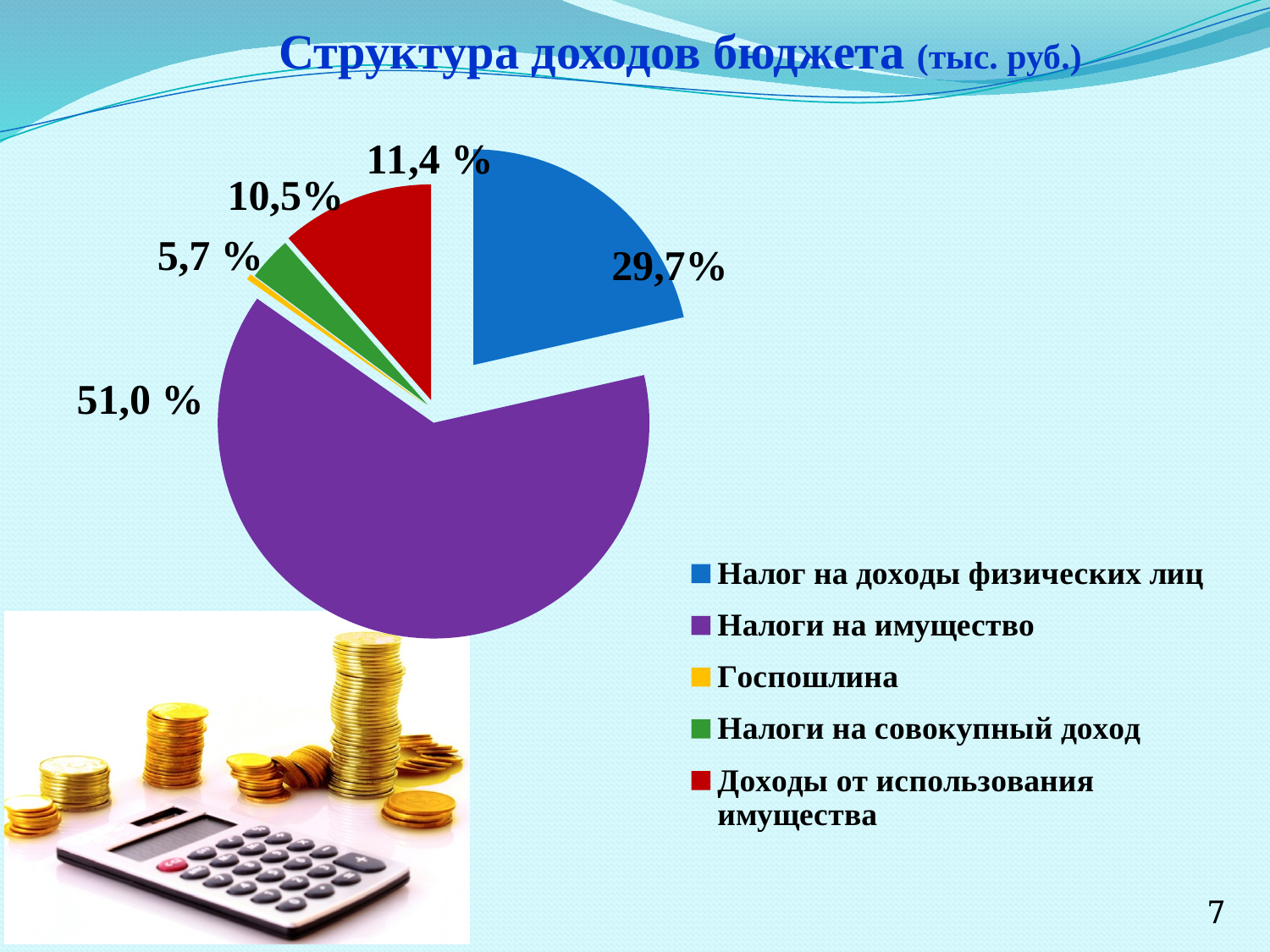
Which category has the largest slice of the pie? Налоги на имущество What kind of chart is shown on the slide? pie chart By how many percentage points does the share of Налоги на имущество exceed the share of Налог на доходы физических лиц? 21,3 Which category has the smallest slice of the pie? Госпошлина What is the title of the chart? Структура доходов бюджета (тыс. руб.) What share of the pie is labelled for Налоги на совокупный доход? 5,7 % What share of the pie is labelled for Налог на доходы физических лиц? 29,7% Which colour represents Госпошлина in the legend? yellow What share of the pie is labelled for Налоги на имущество? 51,0 % Which is larger: the slice for Налог на доходы физических лиц or the slice for Налоги на имущество? Налоги на имущество How many slices does the pie chart have? 5 How many entries does the legend list? 5